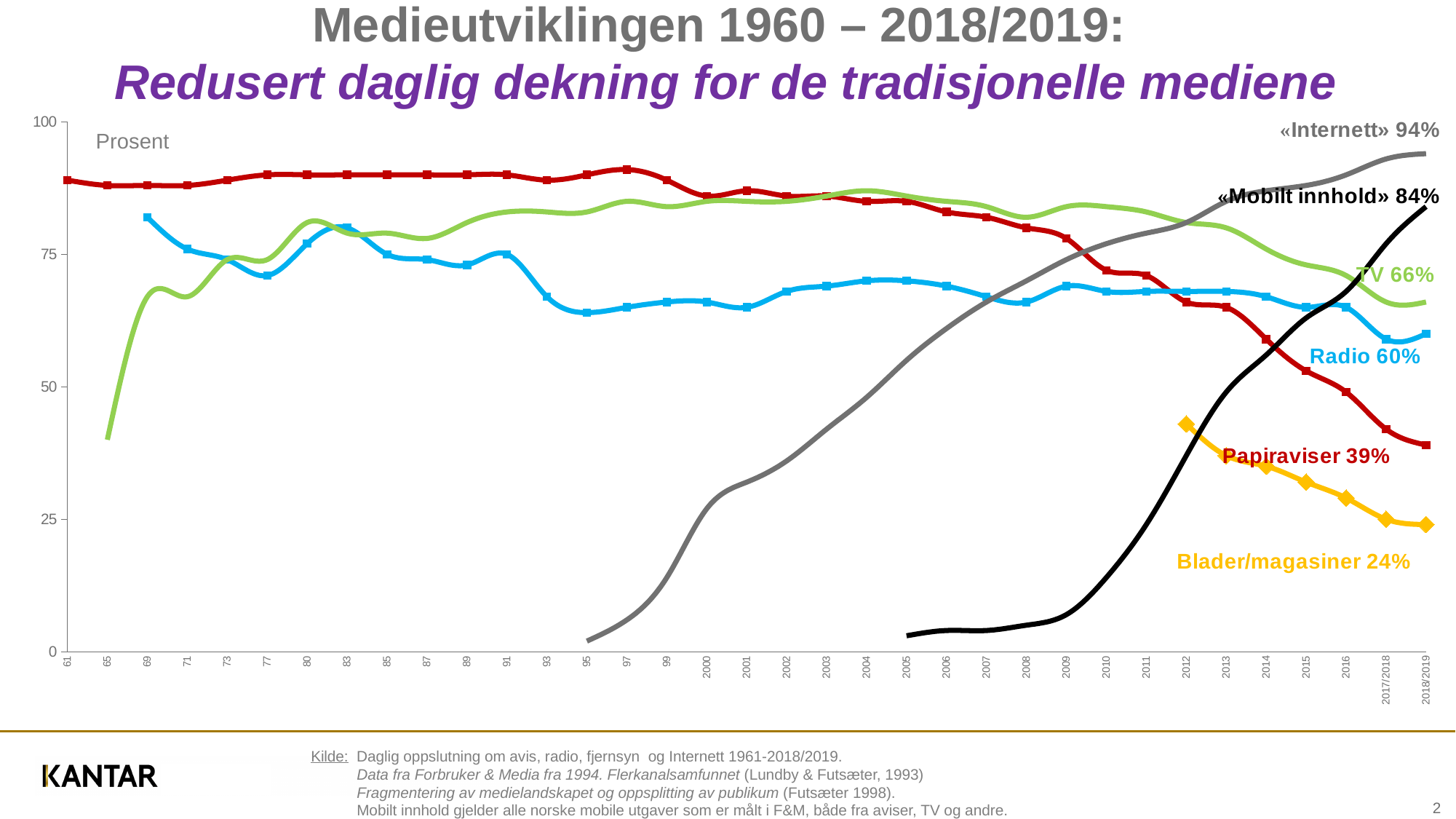
What is the difference between the final values for «Internett» and «Mobilt innhold»? 10 percentage points What is the final value shown for «Internett» in 2018/2019? 94% Is the value for «Internett» in 2000 greater or less than 50? less What kind of chart is shown on the slide? Line chart Which medium has the lowest daily coverage at the end of the series (2018/2019)? Blader/magasiner Which medium has the highest daily coverage at the end of the series (2018/2019)? «Internett» What is the difference between the final values for Papiraviser and Blader/magasiner? 15 percentage points What is the final value shown for Blader/magasiner? 24% What is the final value shown for Papiraviser? 39% What is the final value shown for «Mobilt innhold»? 84% Does the Papiraviser line rise or fall from 2000 to 2018/2019? Fall At the end of the series, which is higher: TV or Radio? TV